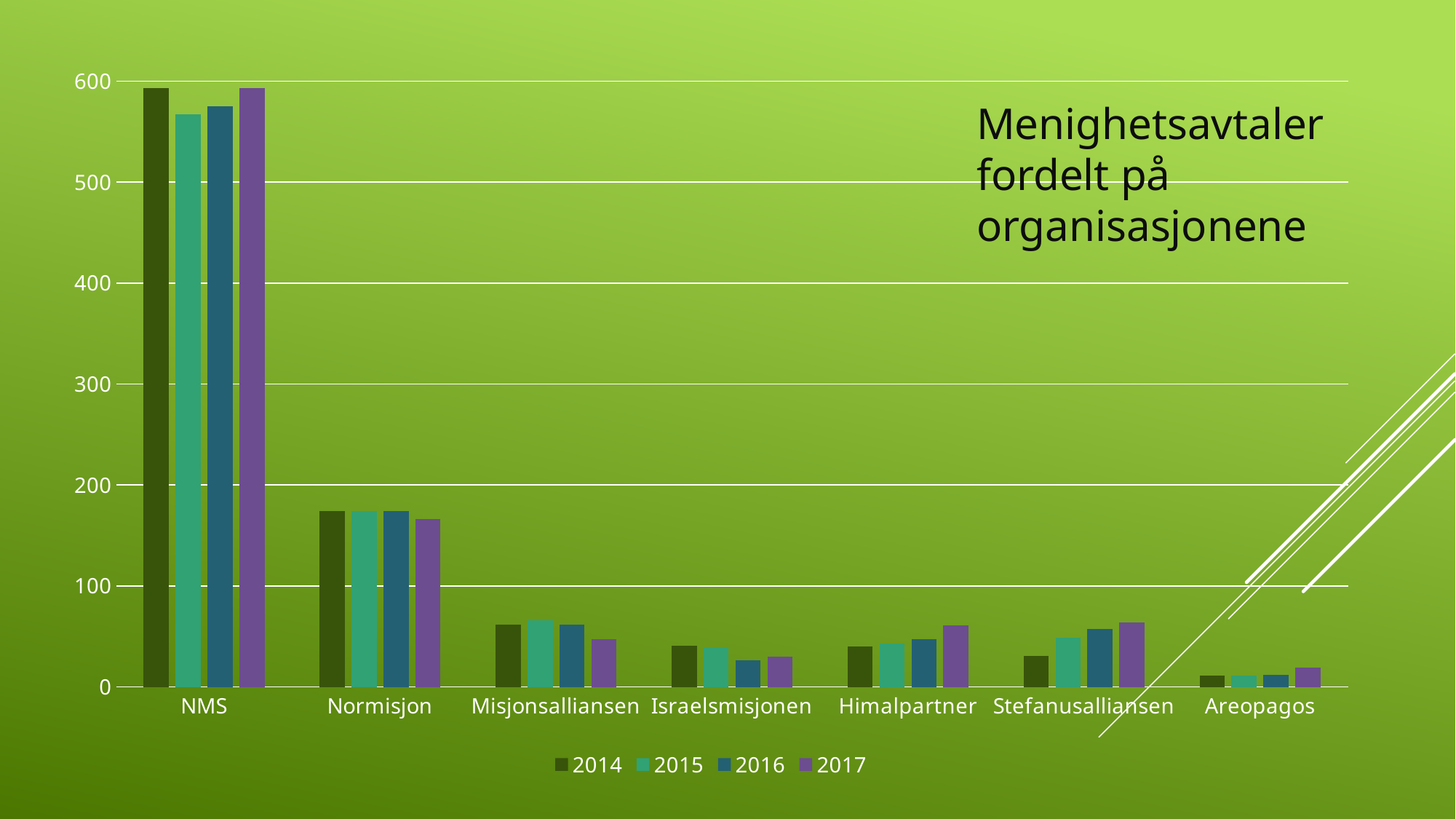
What kind of chart is shown on the slide? bar chart Which organisation has the lowest values in the chart? Areopagos Is the value for NMS in 2014 greater or less than 500? greater Is the value for Misjonsalliansen in 2015 greater or less than 100? less How many series does the legend list? 4 Which organisation has the highest values in the chart? NMS Which is larger for Stefanusalliansen: the 2014 value or the 2017 value? 2017 What is the title of the chart? Menighetsavtaler fordelt på organisasjonene How many organisations (categories) are shown on the x axis? 7 Is the value for Normisjon in 2017 greater or less than 200? less Do the values for Himalpartner rise or fall from 2014 to 2017? rise